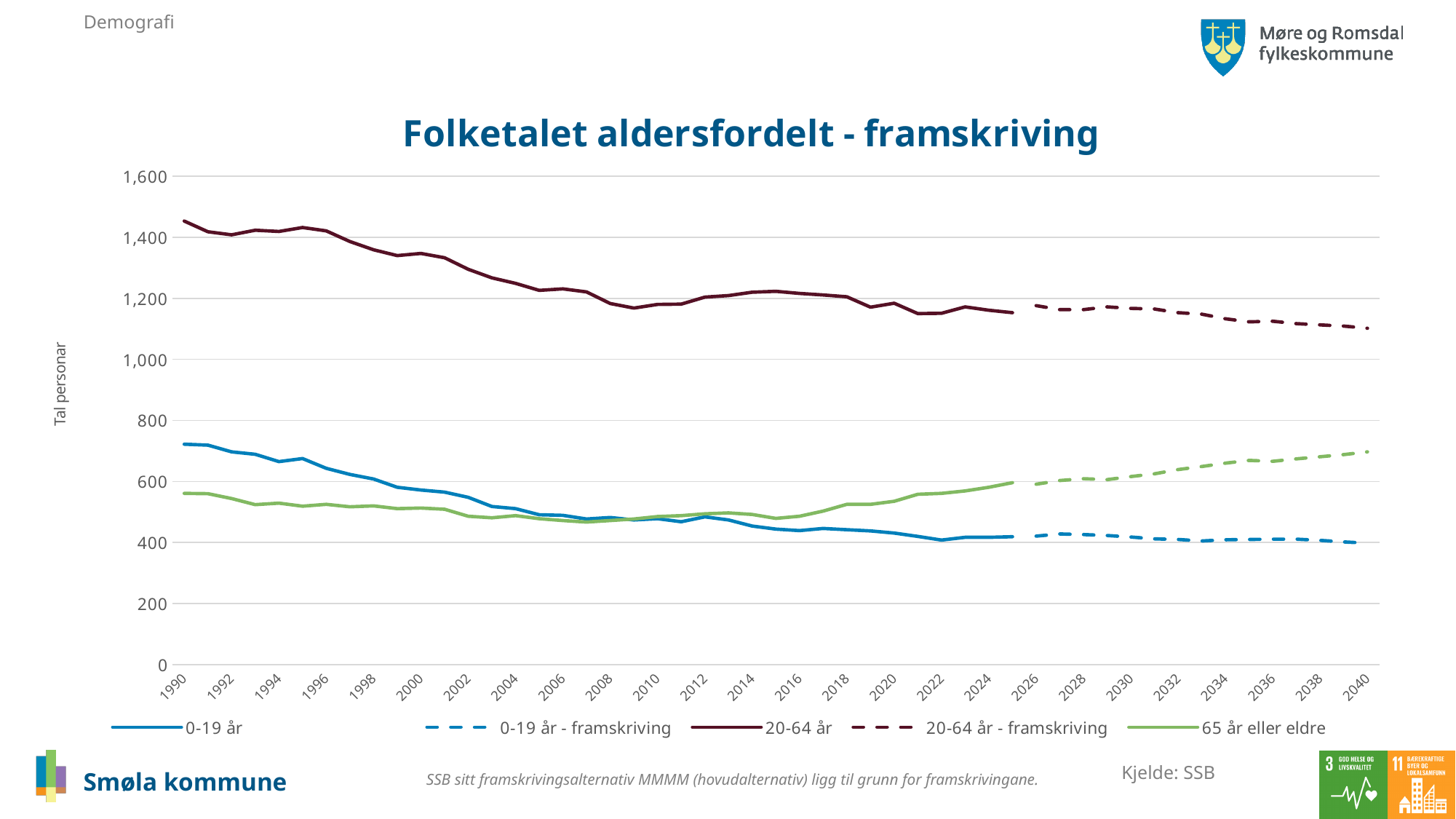
Is the value for 20-64 år in 1990 greater or less than 1,400? greater How many series does the legend list? 5 What kind of chart is shown on the slide? line chart Is the value for 20-64 år in 2024 greater or less than 1,200? less What is the title of the chart? Folketalet aldersfordelt - framskriving Is the value for 65 år eller eldre in 1990 greater or less than 600? less Does the 20-64 år series rise or fall from 1990 to 2024? fall What is the label on the vertical axis? Tal personar Which is larger in 1990, the value for 0-19 år or the value for 65 år eller eldre? 0-19 år Which series has the highest values across the whole chart? 20-64 år Which is larger in 2024, the value for 0-19 år or the value for 65 år eller eldre? 65 år eller eldre